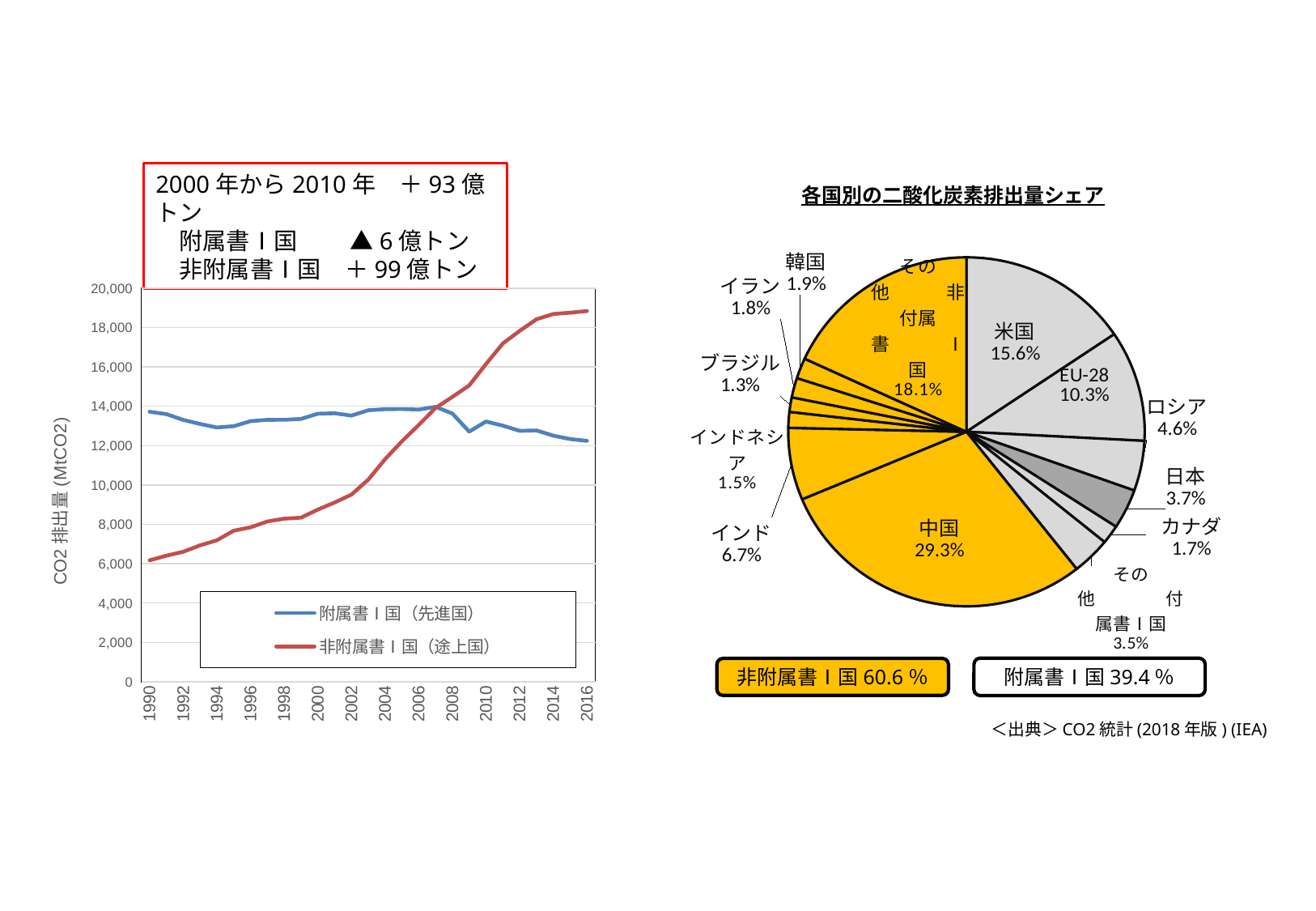
In the pie chart 各国別の二酸化炭素排出量シェア, what share of emissions is attributed to 米国? 15.6% In the pie chart 各国別の二酸化炭素排出量シェア, how many slices does the pie have? 13 In the pie chart 各国別の二酸化炭素排出量シェア, how many percentage points larger is the share of 米国 than that of EU-28? 5.3 percentage points In the line chart on the left, does the 非附属書Ⅰ国（途上国） series rise or fall from 1990 to 2016? Rises In the pie chart 各国別の二酸化炭素排出量シェア, what share of emissions is attributed to 中国? 29.3% What kind of chart is the chart on the left side of the slide? Line chart In the line chart on the left, how many series does the legend list? 2 In the pie chart 各国別の二酸化炭素排出量シェア, which has the larger share, インド or ロシア? インド In the pie chart 各国別の二酸化炭素排出量シェア, what is the combined share of the 非附属書Ⅰ国 group shown below the chart? 60.6% In the pie chart 各国別の二酸化炭素排出量シェア, which country or group has the largest slice? 中国 In the pie chart 各国別の二酸化炭素排出量シェア, which country has the smallest labelled slice? ブラジル In the line chart on the left, is the value for 非附属書Ⅰ国（途上国） in 2016 greater or less than 18,000? greater